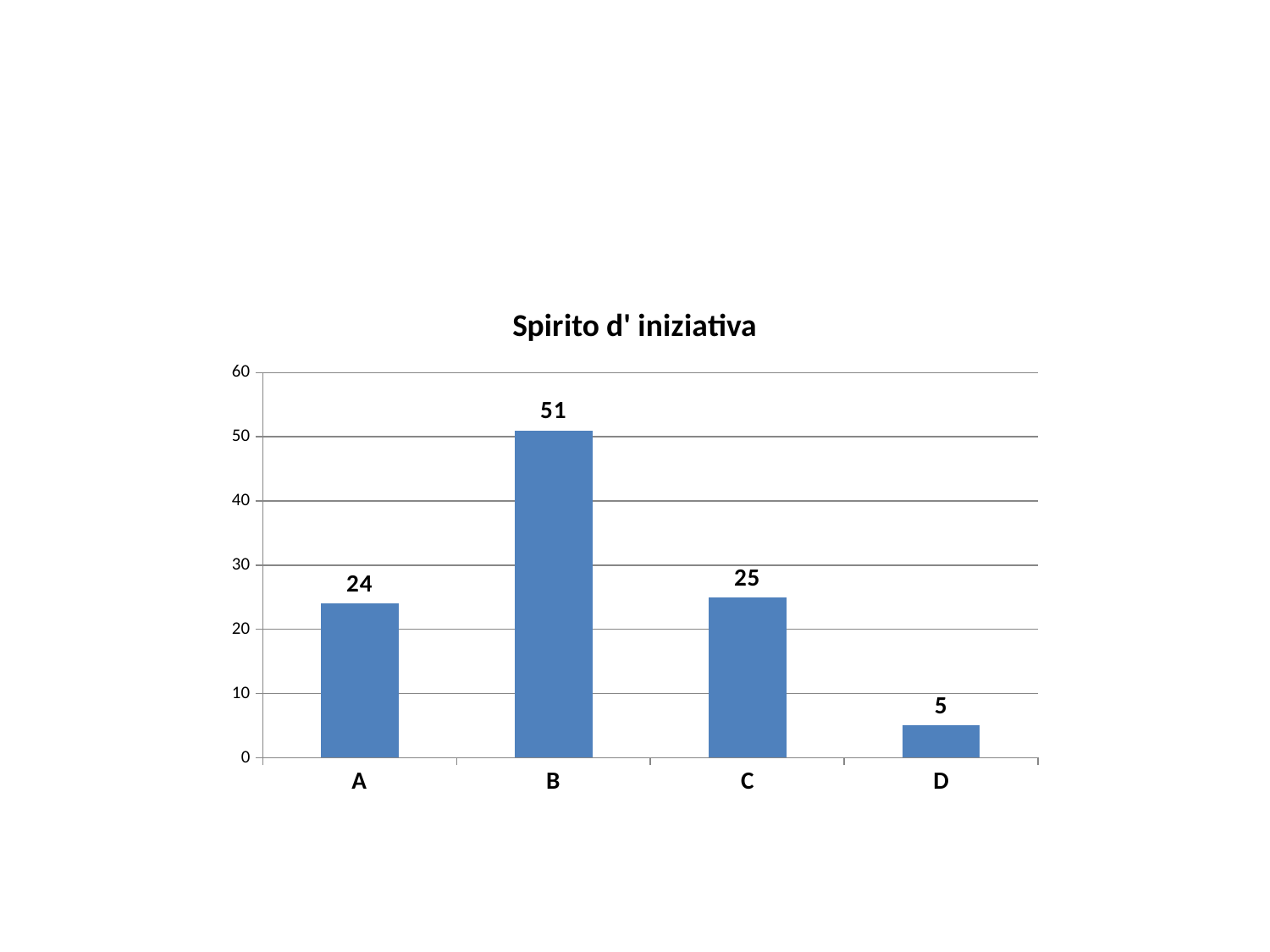
Which category has the lowest value? D What is the difference between the values for A and D? 19 What is the title of the chart? Spirito d' iniziativa Which category has the highest value? B What kind of chart is shown on the slide? bar chart What is the value for category A? 24 What is the value for category D? 5 What is the difference between the values for B and C? 26 Is the value for B greater or less than 40? greater What is the value for category B? 51 Which is larger, the value for B or the value for A? B How many categories are shown on the x axis? 4